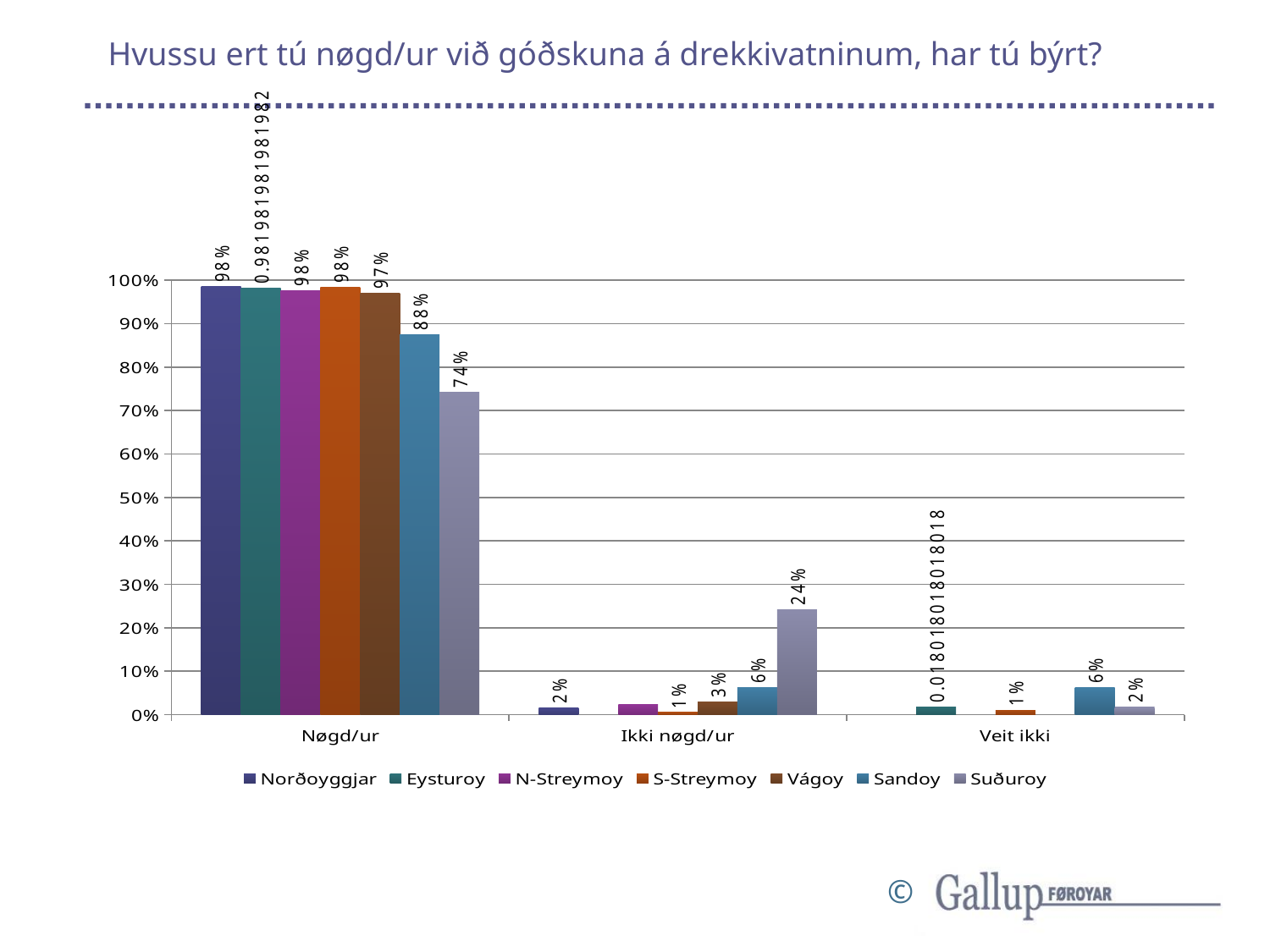
Which region has the lowest value in the Nøgd/ur category? Suðuroy How many categories are shown on the x axis? 3 What is the value for Vágoy in the Nøgd/ur category? 97% What kind of chart is shown on the slide? Bar chart What is the value for Suðuroy in the Nøgd/ur category? 74% Which region has the highest value in the Ikki nøgd/ur category? Suðuroy Is the value for Suðuroy in the Ikki nøgd/ur category greater or less than 20%? greater What is the value for Suðuroy in the Ikki nøgd/ur category? 24% What is the difference between Sandoy and Suðuroy in the Nøgd/ur category? 14 percentage points What is the value for Sandoy in the Nøgd/ur category? 88% How many series does the legend list? 7 In the Ikki nøgd/ur category, which is larger: Vágoy or Sandoy? Sandoy